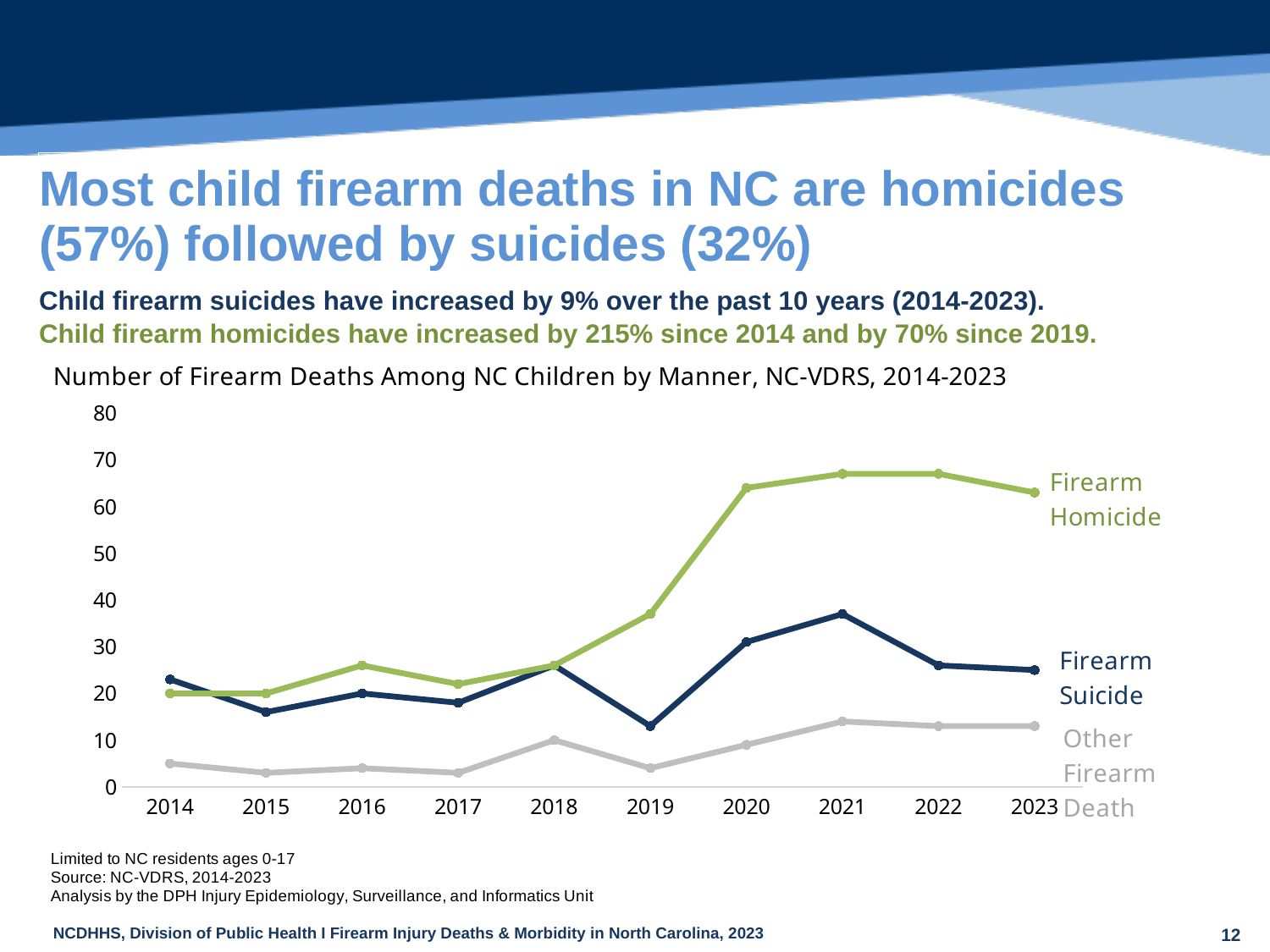
Is the value for Firearm Homicide in 2021 greater or less than 60? greater Which series has the highest value in 2023? Firearm Homicide Does the Firearm Homicide line rise or fall from 2018 to 2021? Rises How many series does the chart show? 3 What is the title of the chart? Number of Firearm Deaths Among NC Children by Manner, NC-VDRS, 2014-2023 What kind of chart is shown on the slide? Line chart How many years are plotted along the x axis? 10 Is the value for Firearm Suicide in 2019 greater or less than 20? less Is the value for Other Firearm Death in 2014 greater or less than 10? less In 2019, which is larger: Firearm Homicide or Firearm Suicide? Firearm Homicide Which series has the lowest values across all years shown? Other Firearm Death